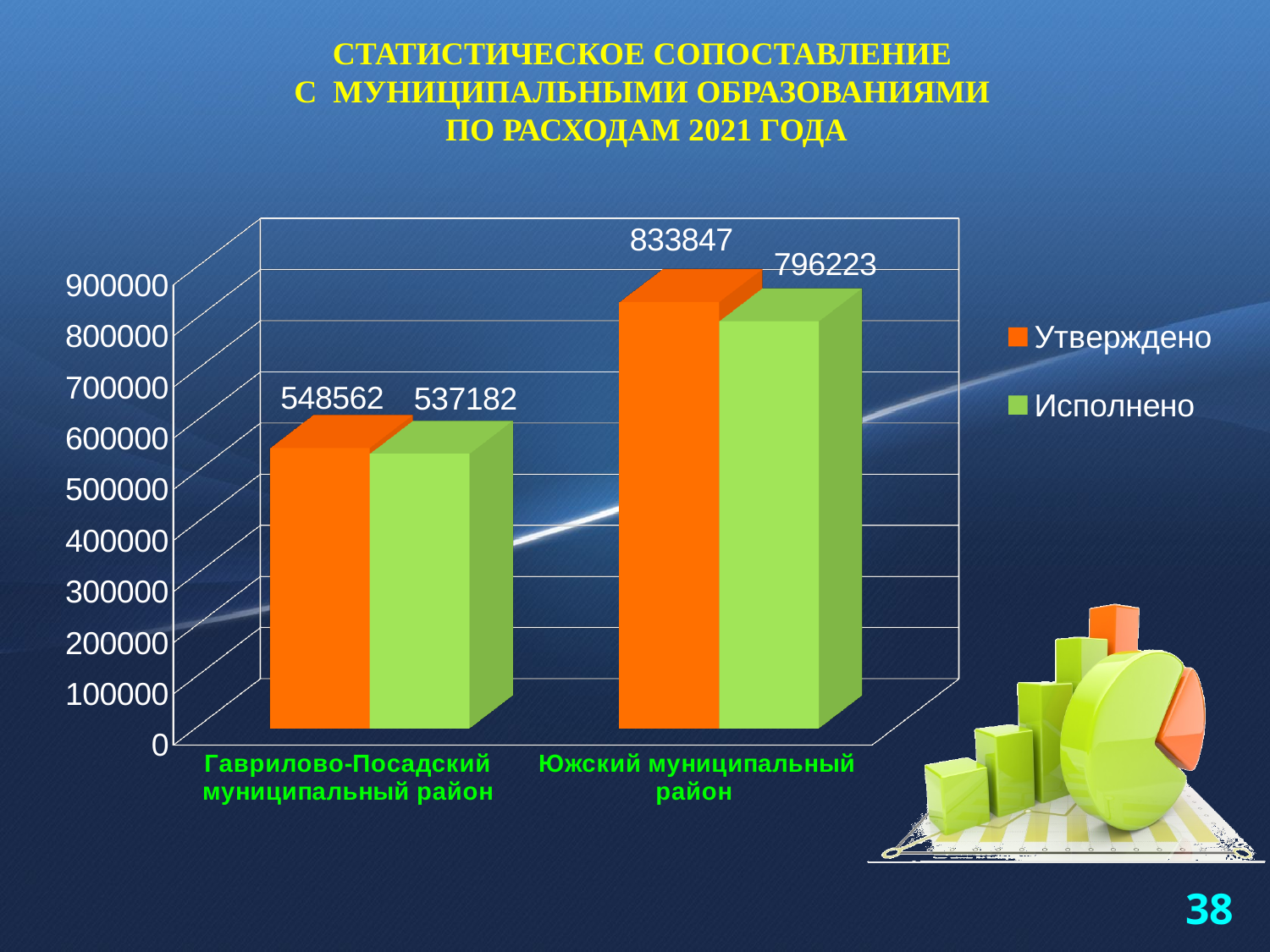
Which category has the highest Утверждено value? Южский муниципальный район What is the Утверждено value for Южский муниципальный район? 833847 What is the difference between Утверждено and Исполнено for Южский муниципальный район? 37624 What is the Исполнено value for Южский муниципальный район? 796223 How many categories are shown on the x axis? 2 Which category has the lowest Исполнено value? Гаврилово-Посадский муниципальный район What is the Утверждено value for Гаврилово-Посадский муниципальный район? 548562 What kind of chart is shown on the slide? Bar chart Which is larger: Утверждено for Гаврилово-Посадский муниципальный район or Исполнено for Южский муниципальный район? Исполнено for Южский муниципальный район What is the difference between Утверждено and Исполнено for Гаврилово-Посадский муниципальный район? 11380 How many series does the legend list? 2 What is the Исполнено value for Гаврилово-Посадский муниципальный район? 537182